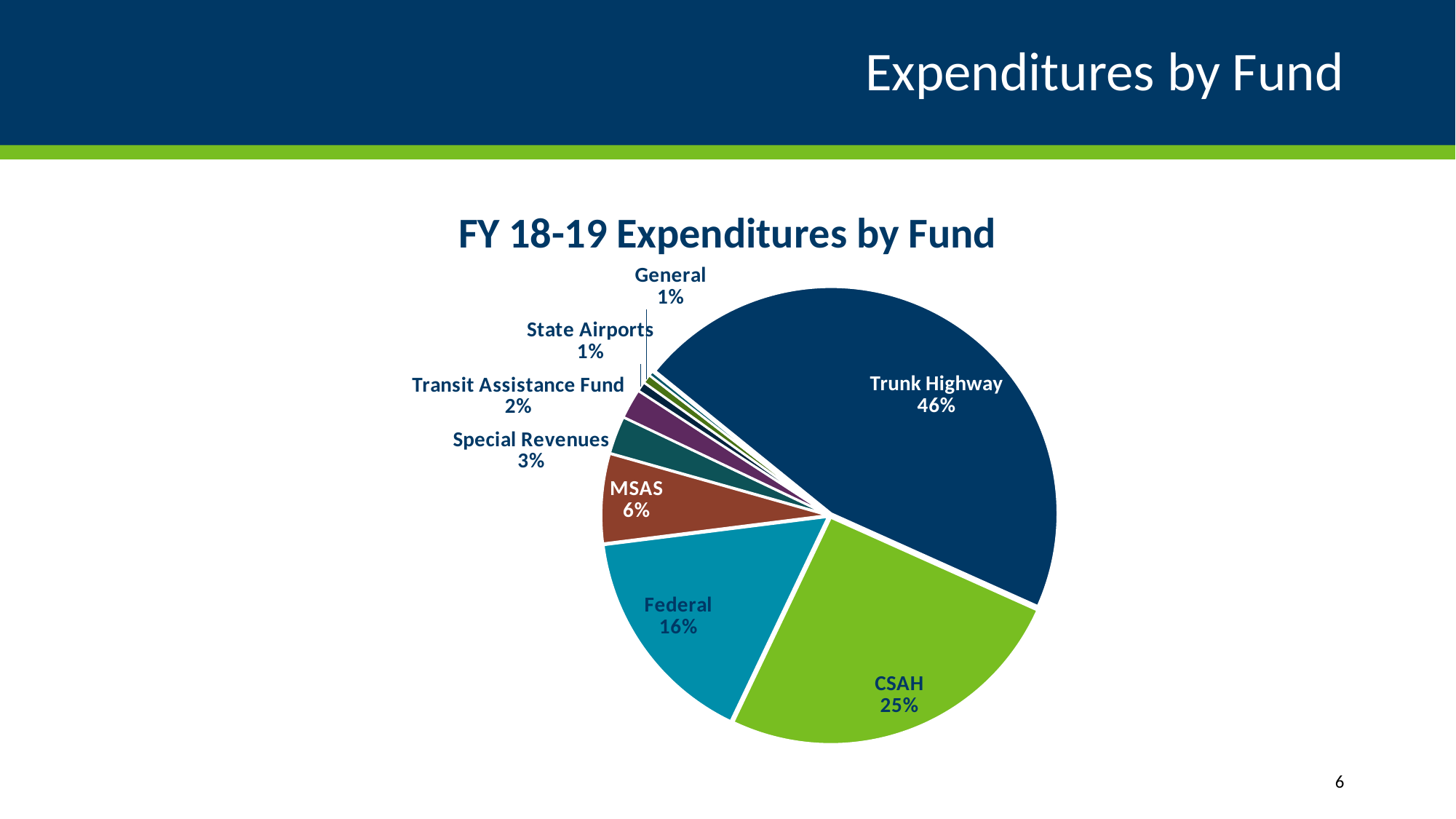
What share of expenditures is MSAS? 6% What kind of chart is shown on the slide? pie chart What share of expenditures is the Transit Assistance Fund? 2% Which fund has the largest share of expenditures? Trunk Highway What share of expenditures is Special Revenues? 3% What is the title of the chart? FY 18-19 Expenditures by Fund What share of expenditures is the Trunk Highway fund? 46% Which is larger, the Federal share or the MSAS share? Federal What share of expenditures is the Federal fund? 16% How many slices does the pie chart have? 9 What is the difference in percentage points between the Trunk Highway and CSAH shares? 21 What share of expenditures is CSAH? 25%